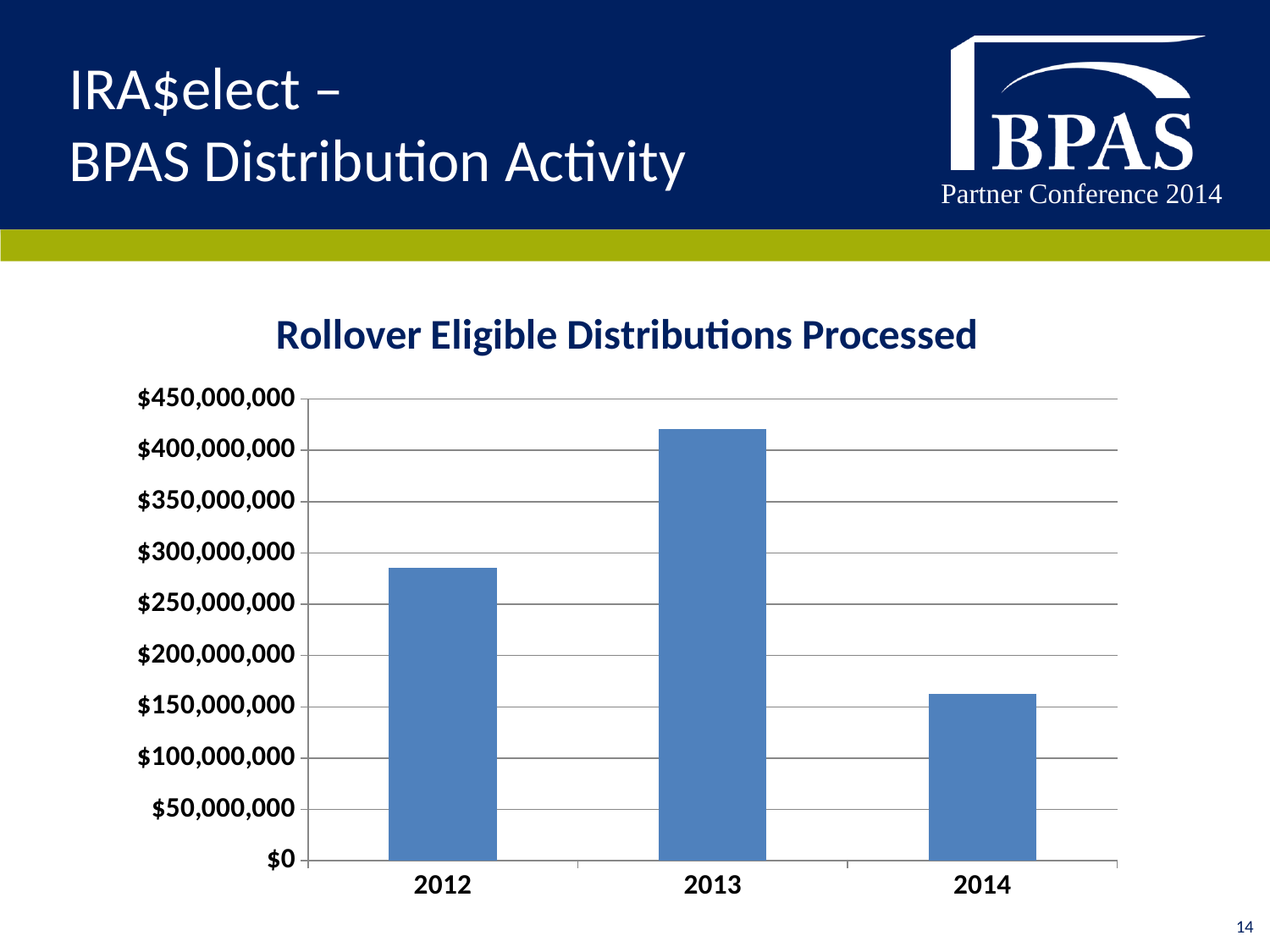
What is the highest value shown on the y axis of the chart? $450,000,000 What type of chart is shown on the slide? bar chart Which year has the lowest value in the chart? 2014 What is the title of the chart? Rollover Eligible Distributions Processed Which is larger, the value for 2012 or the value for 2014? 2012 Is the value for 2014 greater or less than $150,000,000? greater Which year has the highest value in the chart? 2013 Is the value for 2012 greater or less than $300,000,000? less Is the value for 2014 greater or less than $200,000,000? less How many years are shown on the x axis of the chart? 3 Does the value rise or fall from 2013 to 2014? fall